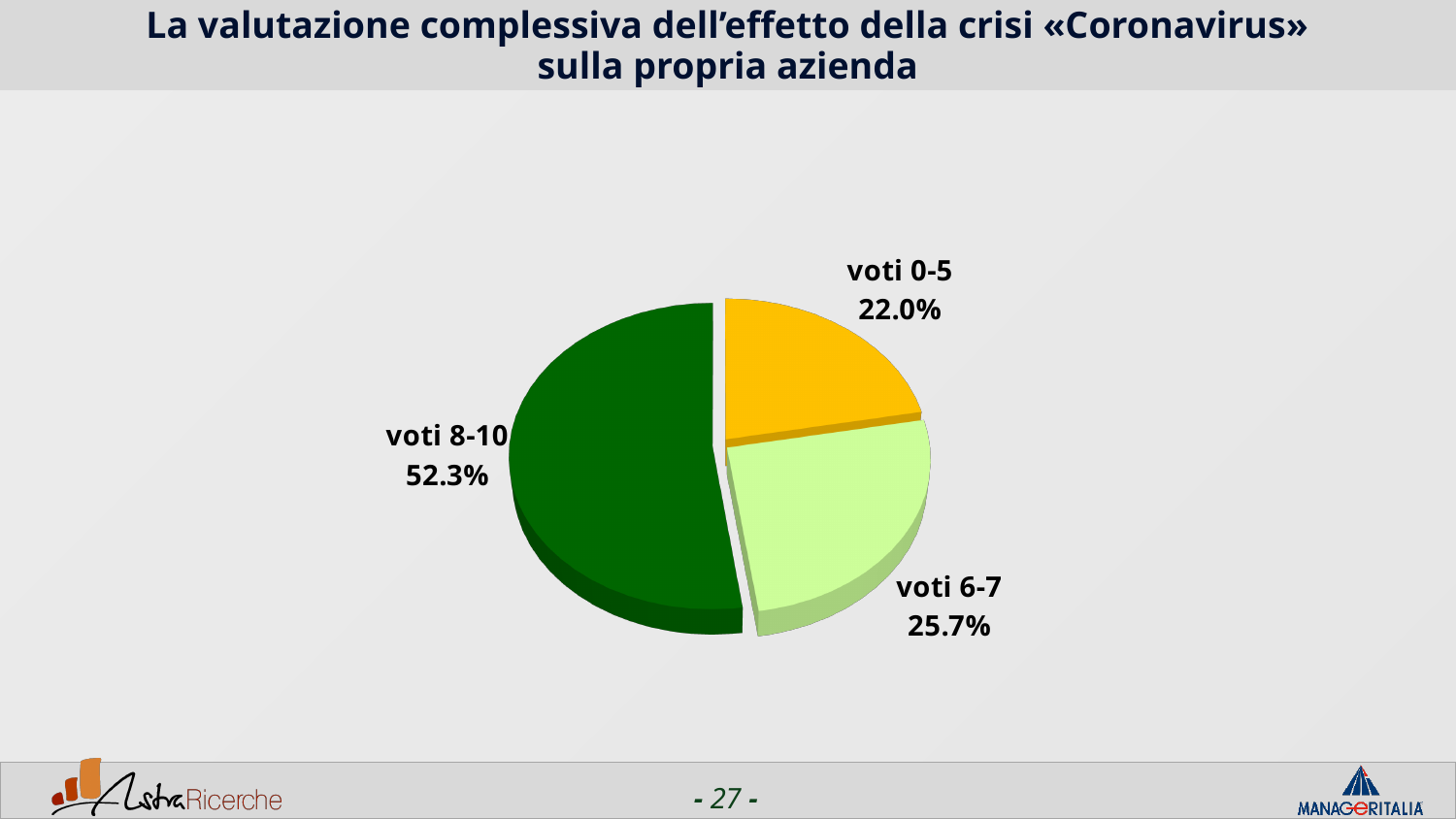
What share of the pie does "voti 8-10" represent? 52.3% Which category has the smallest slice of the pie? voti 0-5 What is the difference in percentage points between "voti 6-7" and "voti 0-5"? 3.7 What is the value shown for "voti 0-5"? 22.0% What kind of chart is shown on the slide? pie chart How many slices does the pie chart have? 3 Is the share for "voti 8-10" greater or less than 50%? greater What is the value shown for "voti 6-7"? 25.7% What is the difference in percentage points between "voti 8-10" and "voti 6-7"? 26.6 What colour is the slice for "voti 0-5"? orange Which category has the largest slice of the pie? voti 8-10 Which is larger, the slice for "voti 6-7" or the slice for "voti 0-5"? voti 6-7